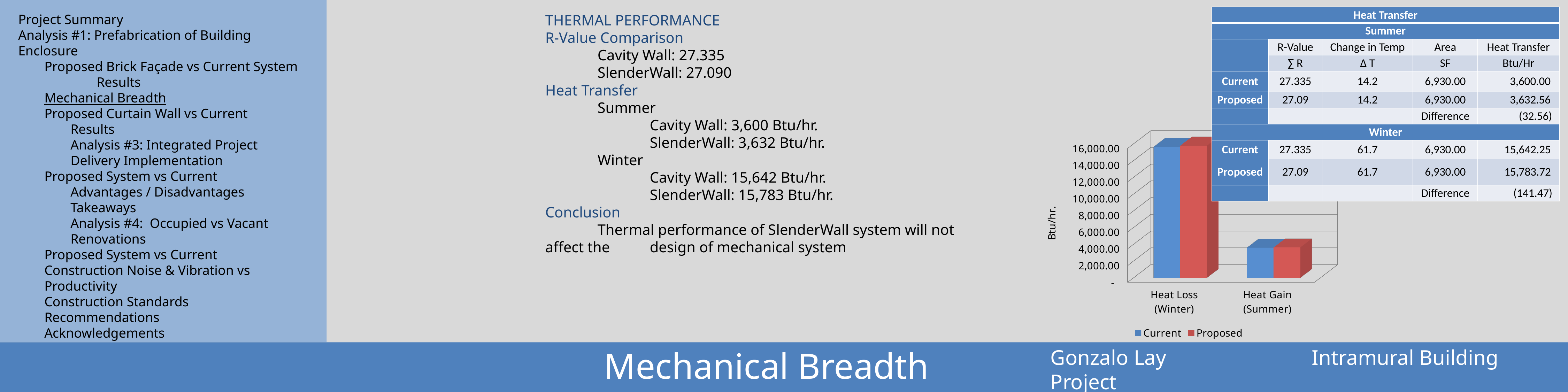
What is the label of the chart's vertical axis? Btu/hr. Is the Proposed value for Heat Gain (Summer) greater or less than 2,000.00? greater Which category has the higher bars, Heat Loss (Winter) or Heat Gain (Summer)? Heat Loss (Winter) Is the Current value for Heat Gain (Summer) greater or less than 6,000.00? less What are the two series named in the chart legend? Current and Proposed Do the bar values rise or fall moving from Heat Loss (Winter) to Heat Gain (Summer) along the x axis? fall How many categories are shown on the x axis of the chart? 2 Which category has the lowest values in the chart? Heat Gain (Summer) How many series does the chart legend list? 2 Is the Current value for Heat Loss (Winter) greater or less than 14,000.00? greater What kind of chart is shown on the slide? bar chart